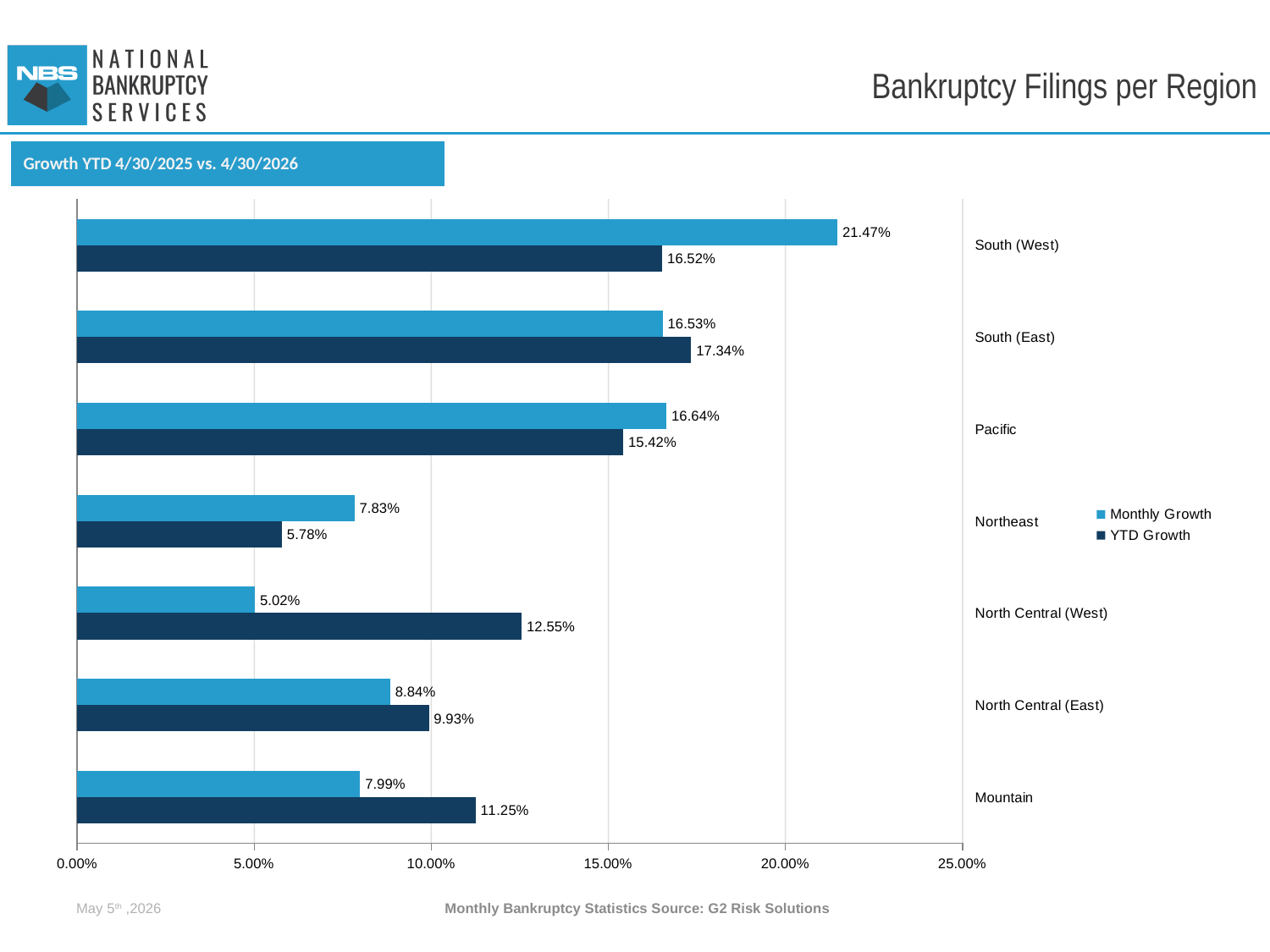
What is the Monthly Growth value for South (West)? 21.47% Which region has the highest Monthly Growth? South (West) Which region has the lowest YTD Growth? Northeast What is the title shown above the chart? Growth YTD 4/30/2025 vs. 4/30/2026 What kind of chart is shown on the slide? Bar chart How many series does the legend list? 2 What is the difference between Monthly Growth and YTD Growth for South (West)? 4.95% What is the YTD Growth value for North Central (West)? 12.55% How many regions are shown on the chart? 7 What is the YTD Growth value for Mountain? 11.25% Which is larger for Pacific, Monthly Growth or YTD Growth? Monthly Growth Which region has the lowest Monthly Growth? North Central (West)